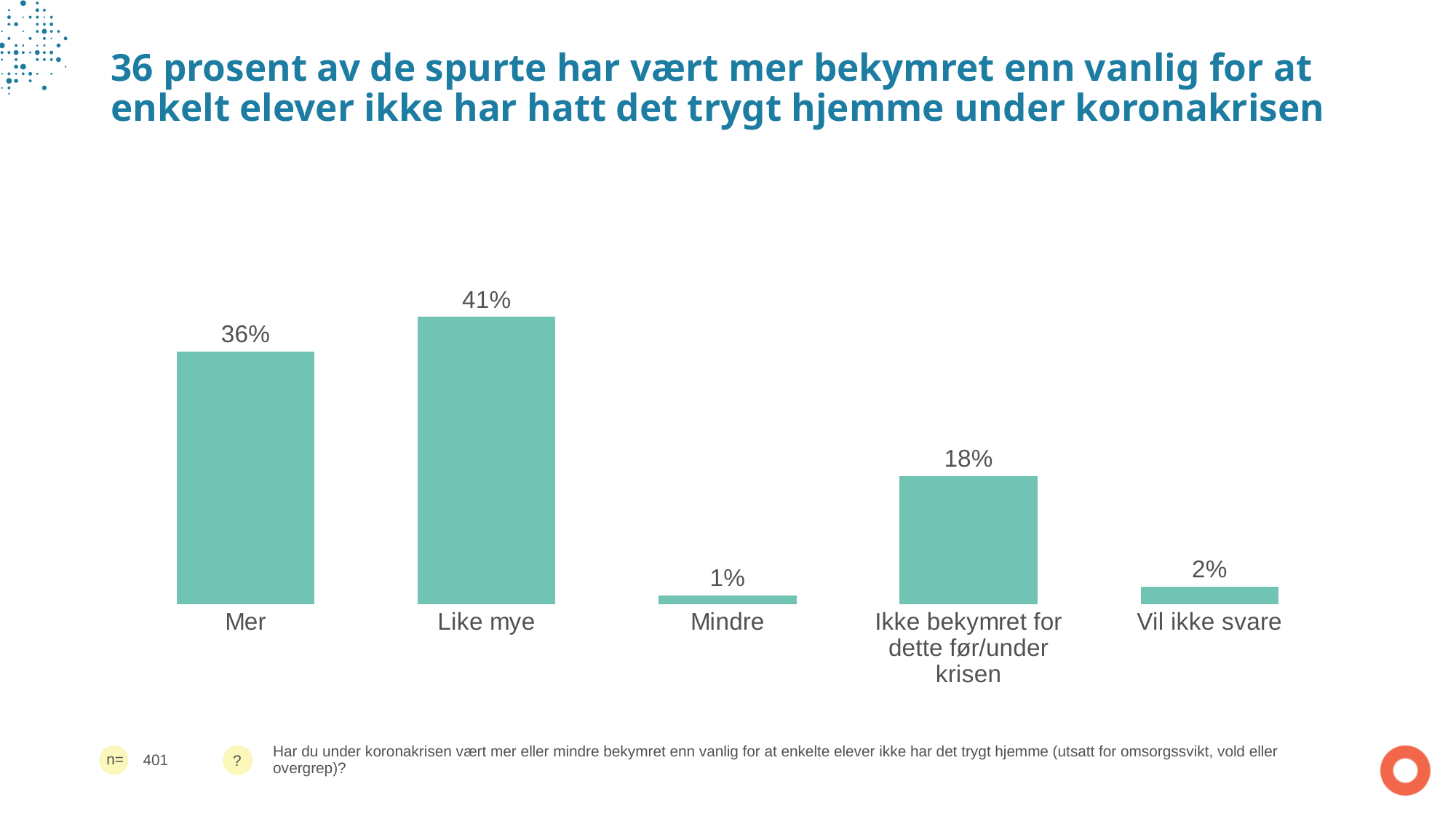
Which category has the highest value? Like mye What is the difference between the values for "Mer" and "Ikke bekymret for dette før/under krisen"? 18% How many categories are shown in the chart? 5 What is the value for "Vil ikke svare"? 2% Which is larger, the value for "Mer" or the value for "Ikke bekymret for dette før/under krisen"? Mer Which category has the lowest value? Mindre What is the sample size (n) shown on the slide? 401 What is the value for "Ikke bekymret for dette før/under krisen"? 18% What is the difference between the values for "Like mye" and "Mer"? 5% What is the value for "Mer"? 36% What kind of chart is shown on the slide? Bar chart What is the value for "Like mye"? 41%